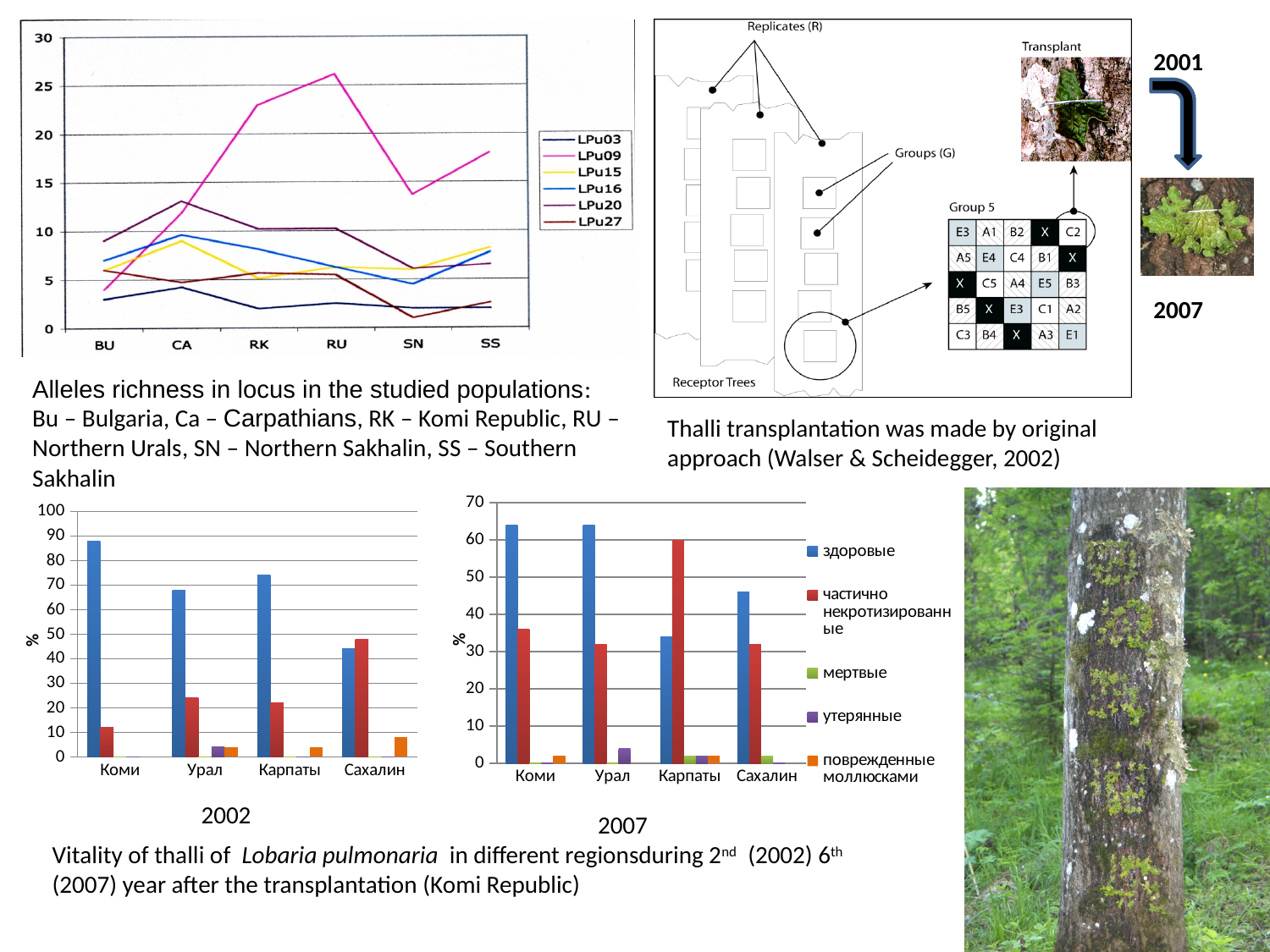
In the top-left line chart of allele richness, is the value of LPu09 at BU greater or less than 5? less In the top-left line chart of allele richness, which series has the highest value at RU? LPu09 In the 2007 bar chart, is the value of здоровые for Сахалин greater or less than 40? greater In the 2002 bar chart, is the value of the blue bar for Коми greater or less than 80? greater In the 2007 bar chart, how many series does the legend list? 5 What kind of chart is the top-left chart showing allele richness in the studied populations? line chart In the top-left line chart of allele richness, how many populations are shown on the x axis? 6 In the 2007 bar chart, which is larger for Карпаты: здоровые or частично некротизированные? частично некротизированные What kind of chart is the 2002 chart at the bottom left of the slide? bar chart In the top-left line chart of allele richness, how many series does the legend list? 6 In the 2002 bar chart, how many regions are shown on the x axis? 4